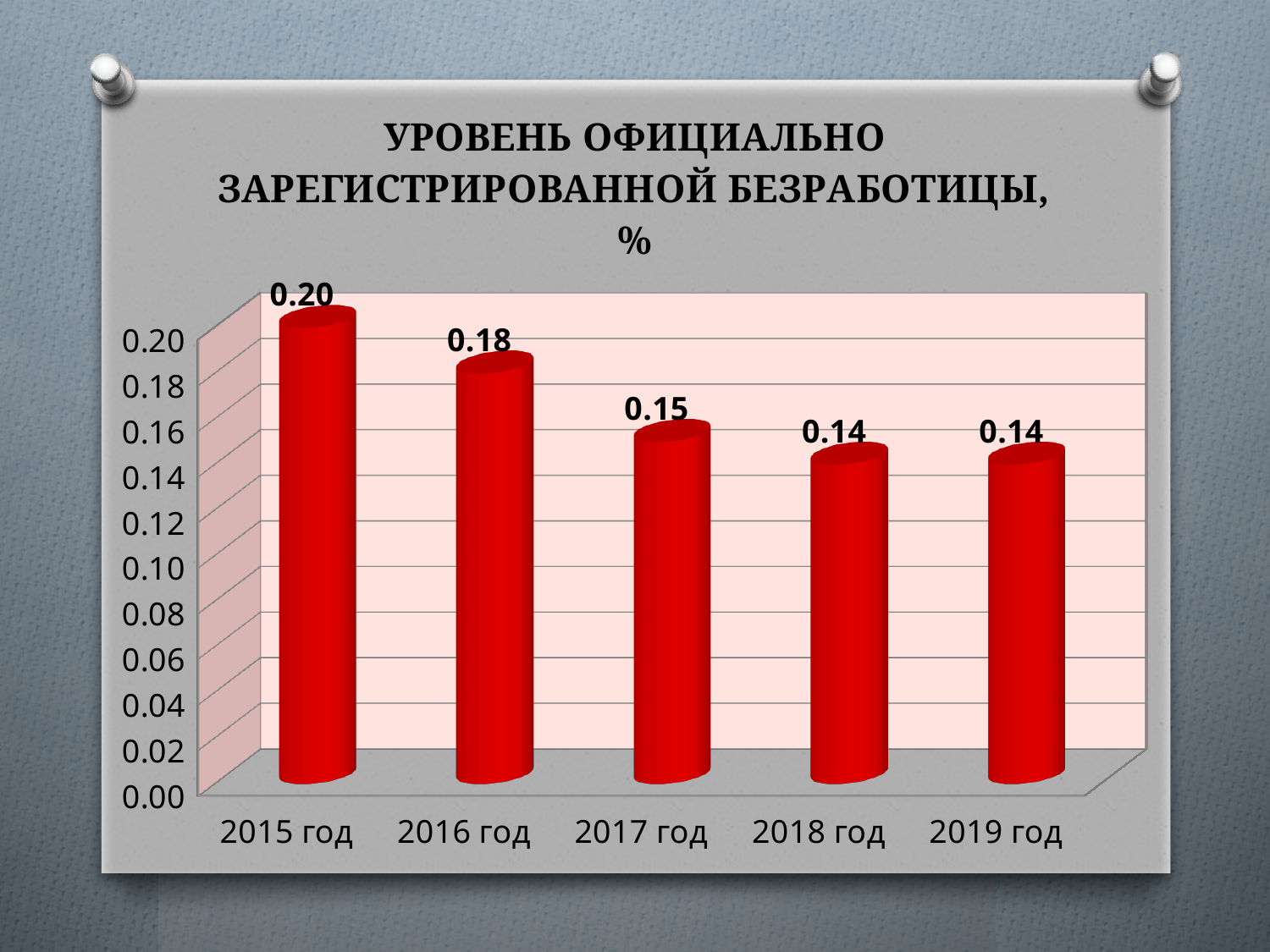
What is the value for 2019 год? 0.14 Do the values rise or fall from 2015 год to 2019 год? fall What is the difference between the values for 2015 год and 2016 год? 0.02 What kind of chart is this? bar chart Which year has the highest value? 2015 год Is the value for 2017 год greater or less than 0.10? greater What is the value for 2015 год? 0.20 Which is larger, the value for 2016 год or the value for 2017 год? 2016 год What is the difference between the values for 2016 год and 2018 год? 0.04 What is the title of the chart? УРОВЕНЬ ОФИЦИАЛЬНО ЗАРЕГИСТРИРОВАННОЙ БЕЗРАБОТИЦЫ, % How many years are shown on the x axis? 5 What is the value for 2017 год? 0.15